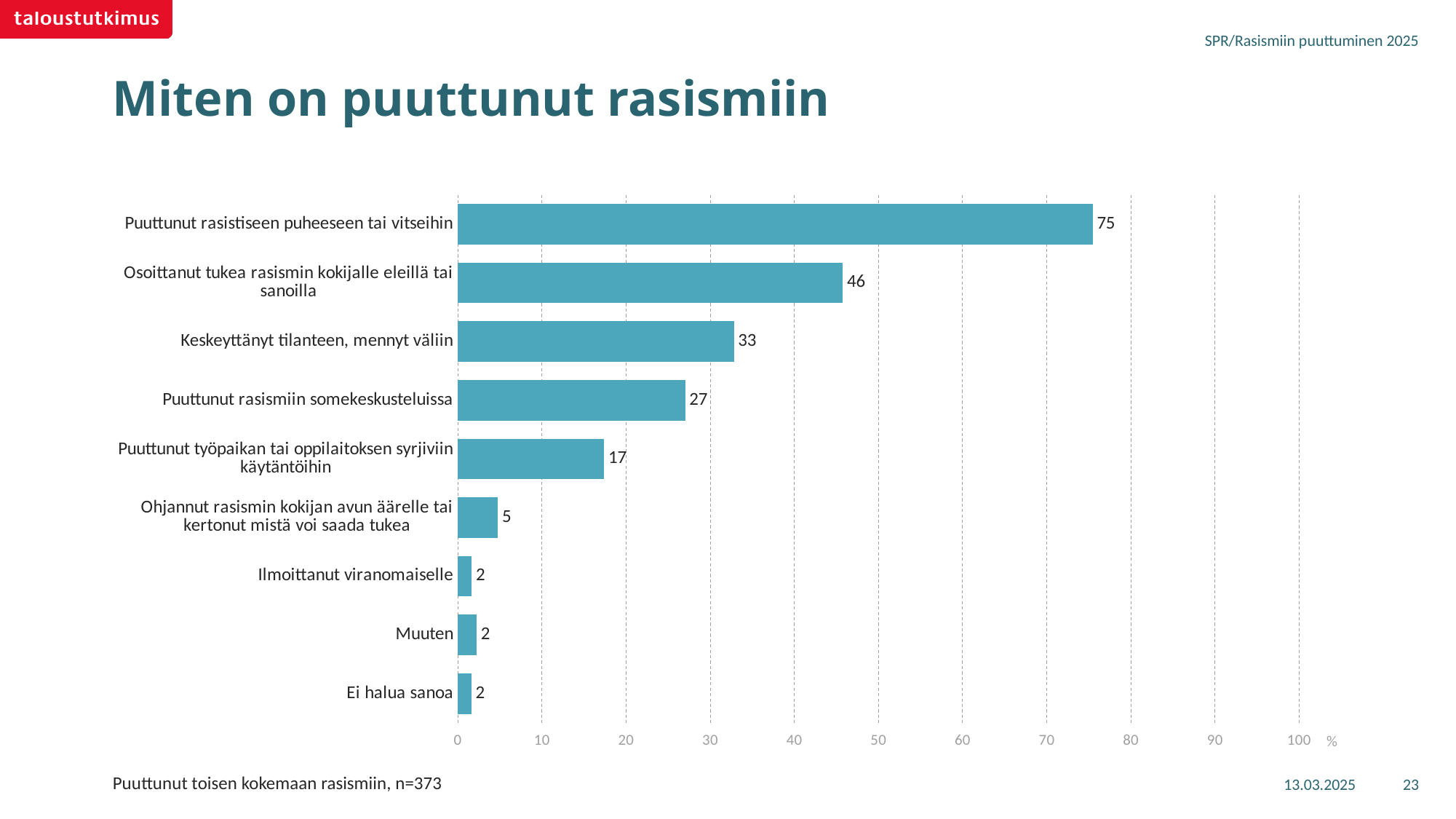
What kind of chart is shown on the slide? bar chart What is the value for "Puuttunut rasismiin somekeskusteluissa"? 27 What is the title of the slide? Miten on puuttunut rasismiin Which category has the highest value? Puuttunut rasistiseen puheeseen tai vitseihin What is the value for "Ohjannut rasismin kokijan avun äärelle tai kertonut mistä voi saada tukea"? 5 What is the difference between the values for "Keskeyttänyt tilanteen, mennyt väliin" and "Puuttunut työpaikan tai oppilaitoksen syrjiviin käytäntöihin"? 16 What is the value for "Osoittanut tukea rasismin kokijalle eleillä tai sanoilla"? 46 Which is larger, the value for "Keskeyttänyt tilanteen, mennyt väliin" or the value for "Puuttunut rasismiin somekeskusteluissa"? Keskeyttänyt tilanteen, mennyt väliin What is the difference between the values for "Puuttunut rasistiseen puheeseen tai vitseihin" and "Osoittanut tukea rasismin kokijalle eleillä tai sanoilla"? 29 How many categories are shown in the chart? 9 What is the value for "Puuttunut rasistiseen puheeseen tai vitseihin"? 75 Is the value for "Osoittanut tukea rasismin kokijalle eleillä tai sanoilla" greater or less than 40? greater